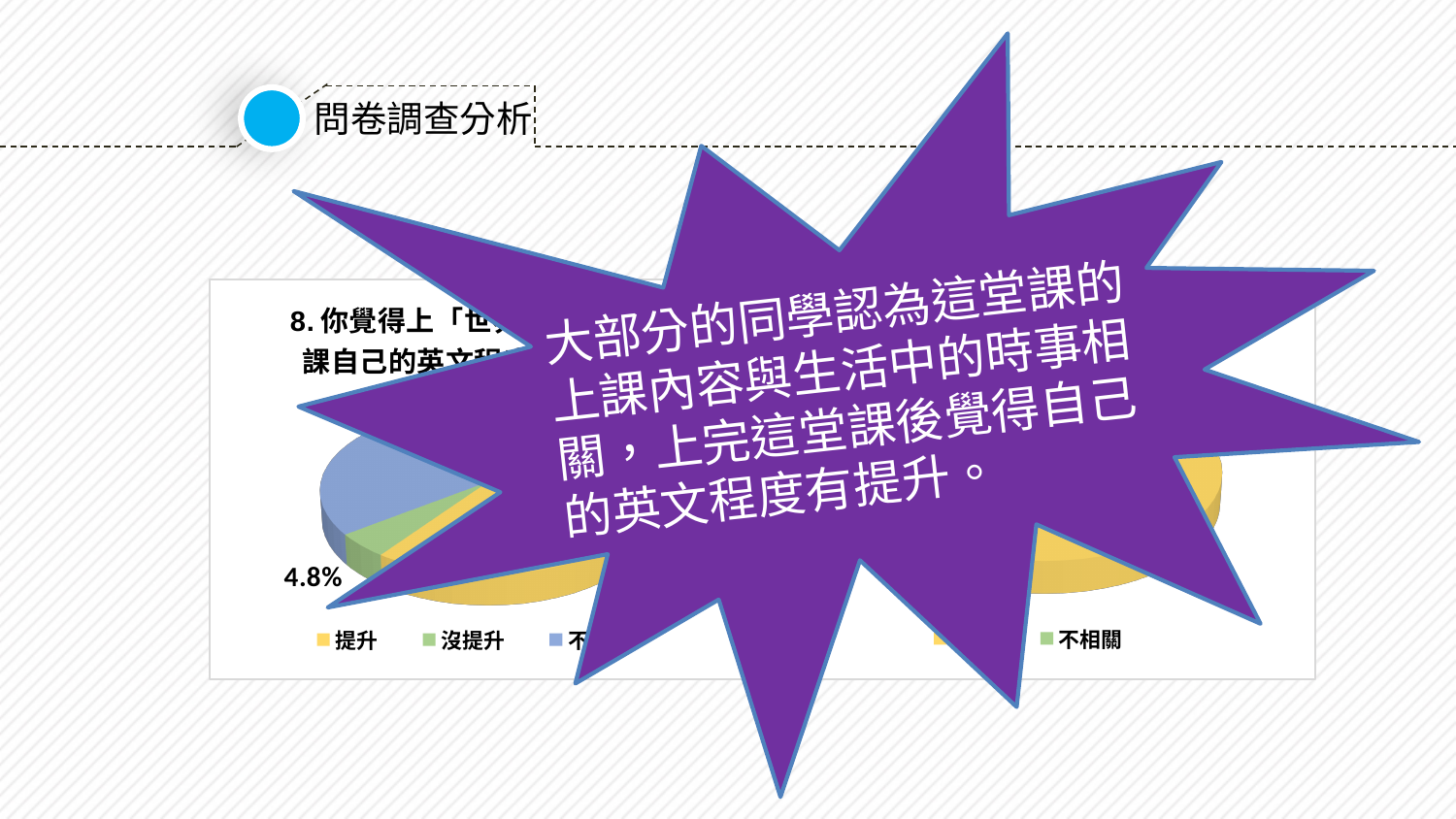
What kind of chart is the left chart on the slide? pie chart On the left chart, which is larger, the slice for 提升 or the slice for 沒提升? 提升 On the left chart, is the share for 提升 greater or less than 50%? greater On the left chart, which category has the largest slice? 提升 What are the first two legend entries of the left chart? 提升, 沒提升 What is the only data label visible on the left chart? 4.8% On the left chart, what colour represents 提升? yellow